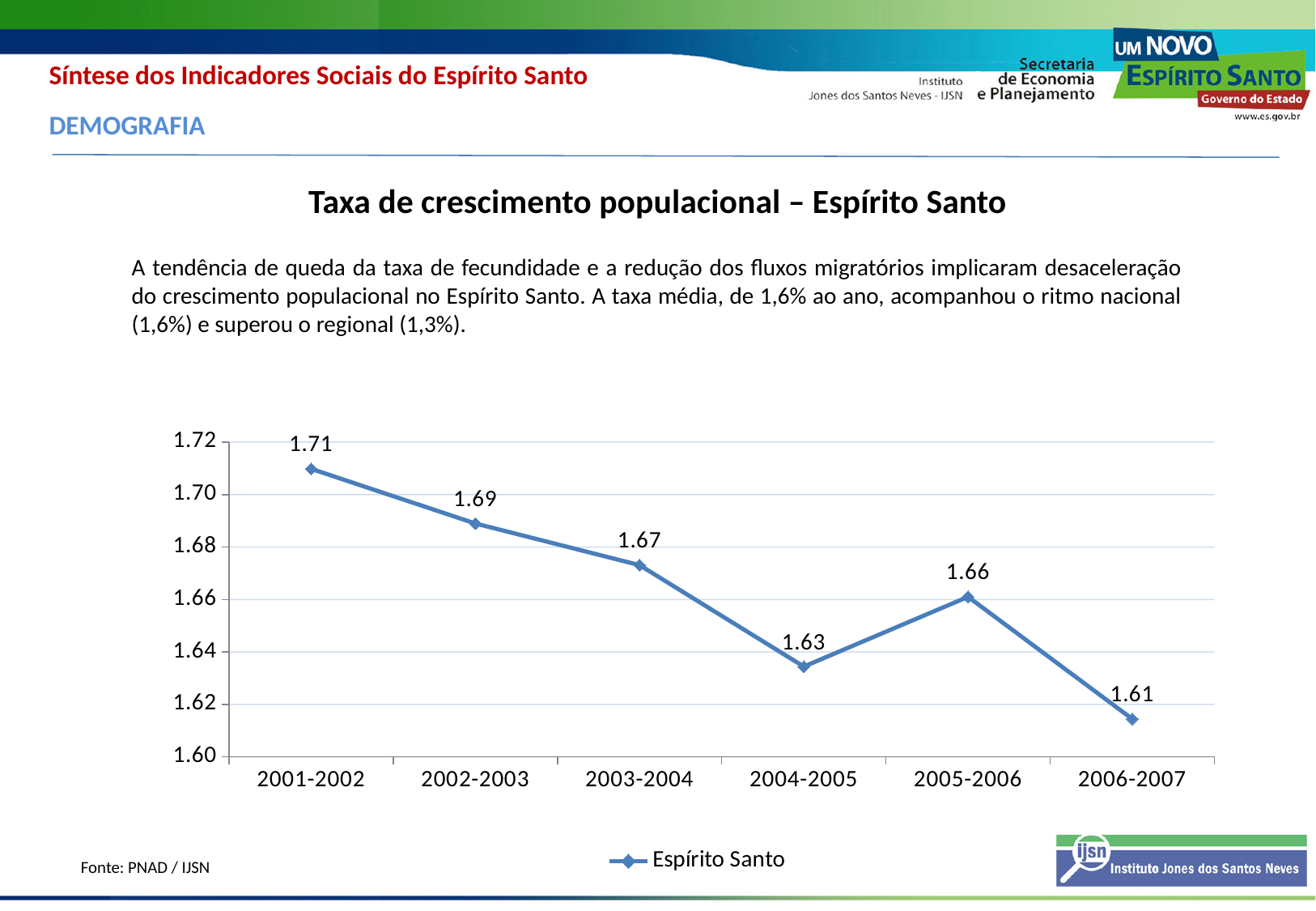
Is the value for 2003-2004 greater or less than 1.66? greater Which period has the highest value? 2001-2002 What is the name of the series shown in the legend? Espírito Santo What is the value for 2004-2005? 1.63 Which is larger, the value for 2005-2006 or the value for 2004-2005? 2005-2006 How many series does the legend list? 1 What is the value for 2006-2007? 1.61 What is the value for 2001-2002? 1.71 Which period has the lowest value? 2006-2007 What kind of chart is shown? line chart What is the difference between the values for 2001-2002 and 2006-2007? 0.10 How many periods are plotted on the x axis? 6